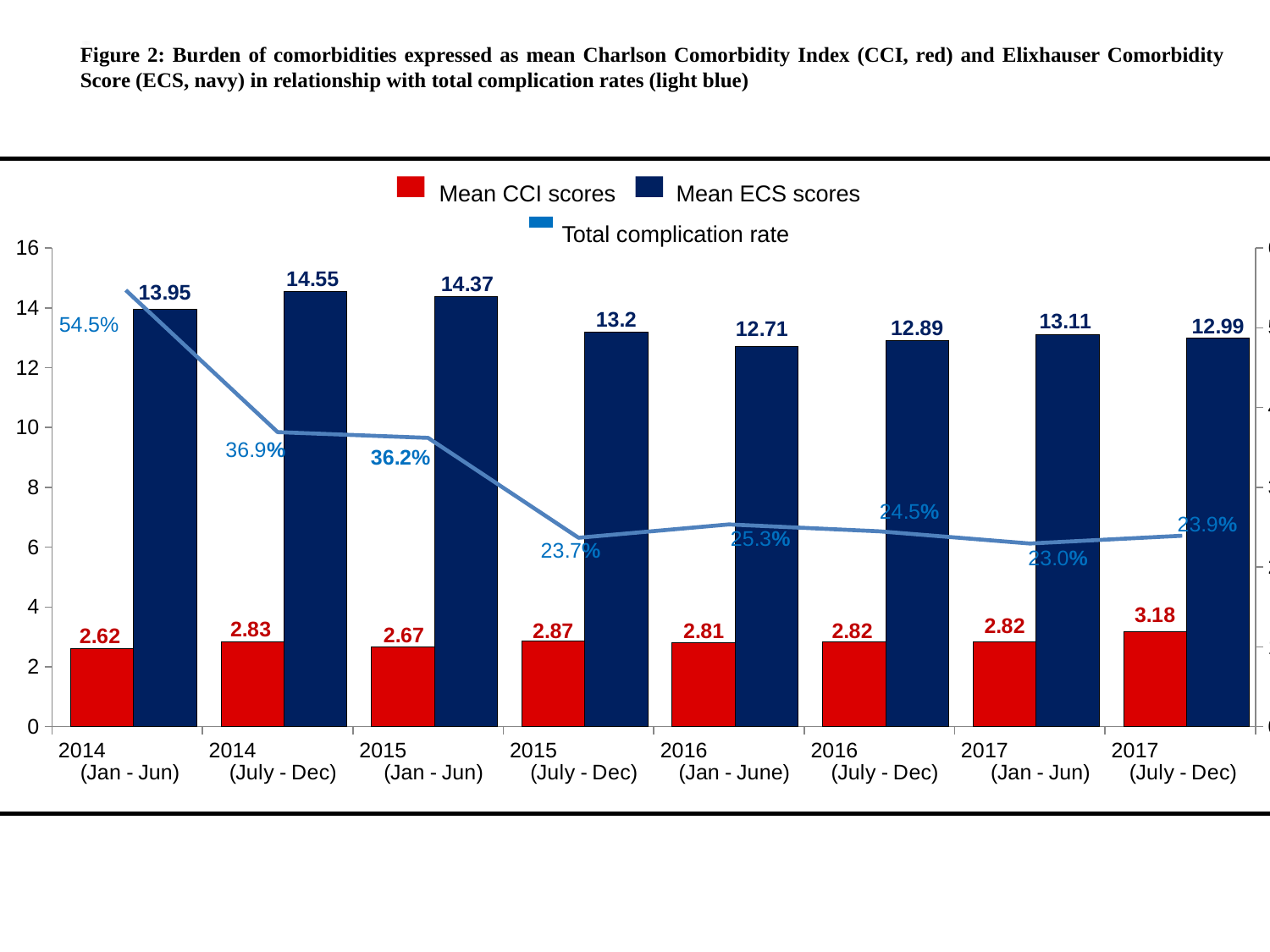
What colour are the Mean CCI score bars? red What is the Mean ECS score for 2014 (July - Dec)? 14.55 What is the difference between the Mean ECS scores for 2014 (July - Dec) and 2016 (Jan - June)? 1.84 How many series does the legend list? 3 What is the Mean CCI score for 2017 (July - Dec)? 3.18 What is the total complication rate for 2014 (Jan - Jun)? 54.5% Which period has the lowest Mean ECS score? 2016 (Jan - June) Which is larger, the Mean CCI score for 2015 (Jan - Jun) or for 2015 (July - Dec)? 2015 (July - Dec) Which period has the lowest total complication rate? 2017 (Jan - Jun) Does the total complication rate generally rise or fall from 2014 (Jan - Jun) to 2017 (July - Dec)? fall Which period has the highest Mean ECS score? 2014 (July - Dec) How many time periods are shown on the x axis? 8